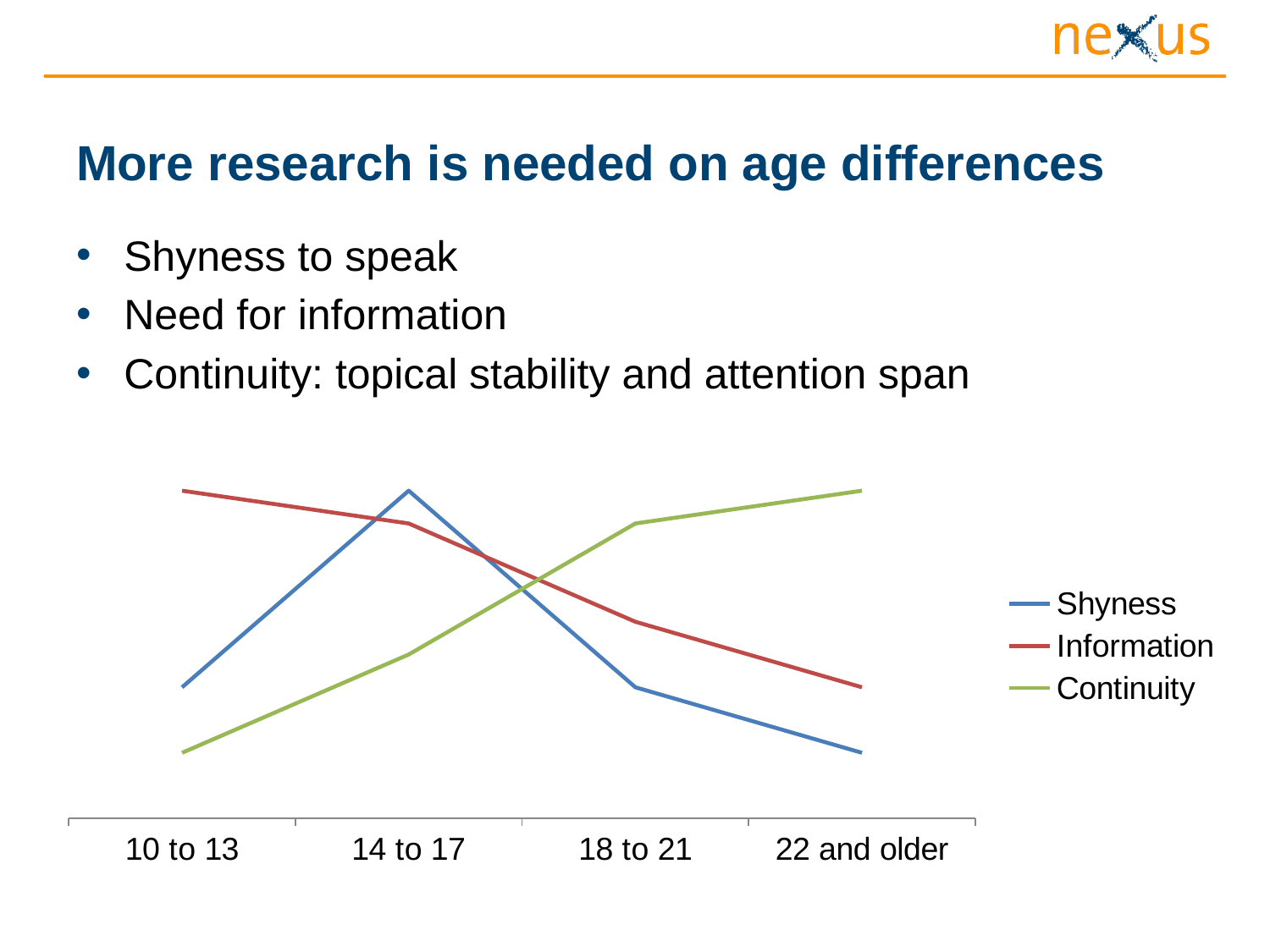
Which age category has the lowest value for Continuity? 10 to 13 What colour is the Continuity line? green Does the Continuity line rise or fall across the age groups from 10 to 13 to 22 and older? rises Which age category has the highest value for Shyness? 14 to 17 How many series does the legend list? 3 Which age category has the lowest value for Shyness? 22 and older At 10 to 13, which is larger: Information or Continuity? Information At 22 and older, which is larger: Shyness or Continuity? Continuity What kind of chart is shown on the slide? line chart Does the Information line rise or fall across the age groups from 10 to 13 to 22 and older? falls Which age category has the highest value for Information? 10 to 13 How many age categories are shown on the x axis? 4